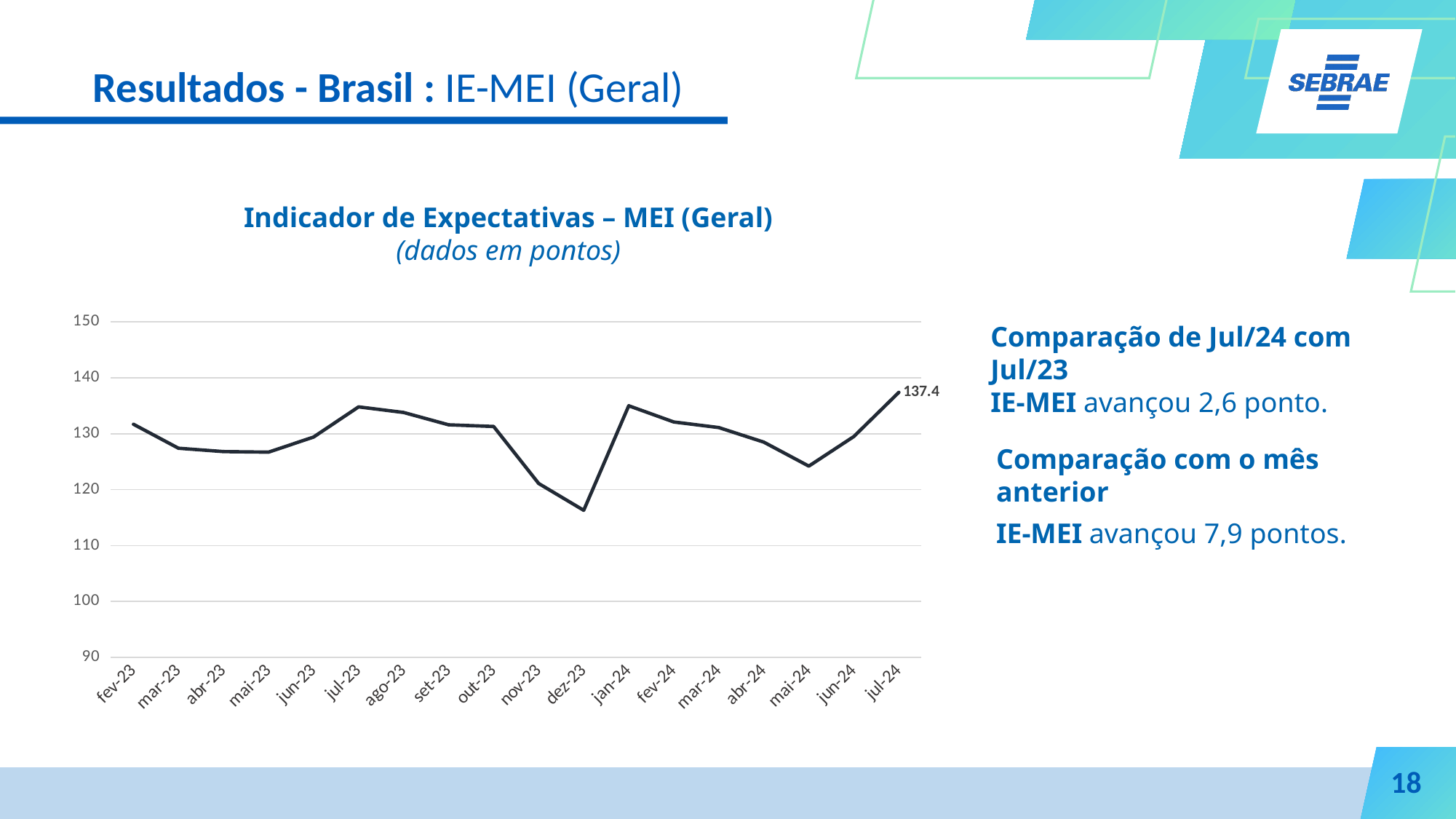
Which month has the highest value on the chart? jul-24 Is the value for dez-23 greater or less than 120? less What is the title of the chart? Indicador de Expectativas – MEI (Geral) What is the first month shown on the x axis? fev-23 Is the value for jul-23 greater or less than 130? greater Which month has the lowest value on the chart? dez-23 Do the values rise or fall from mai-24 to jul-24? rise Is the value for mai-24 greater or less than 130? less Which is larger, the value for dez-23 or the value for jan-24? jan-24 What is the value for jul-24 on the chart? 137.4 How many months are plotted along the x axis? 18 What kind of chart is shown on the slide? line chart